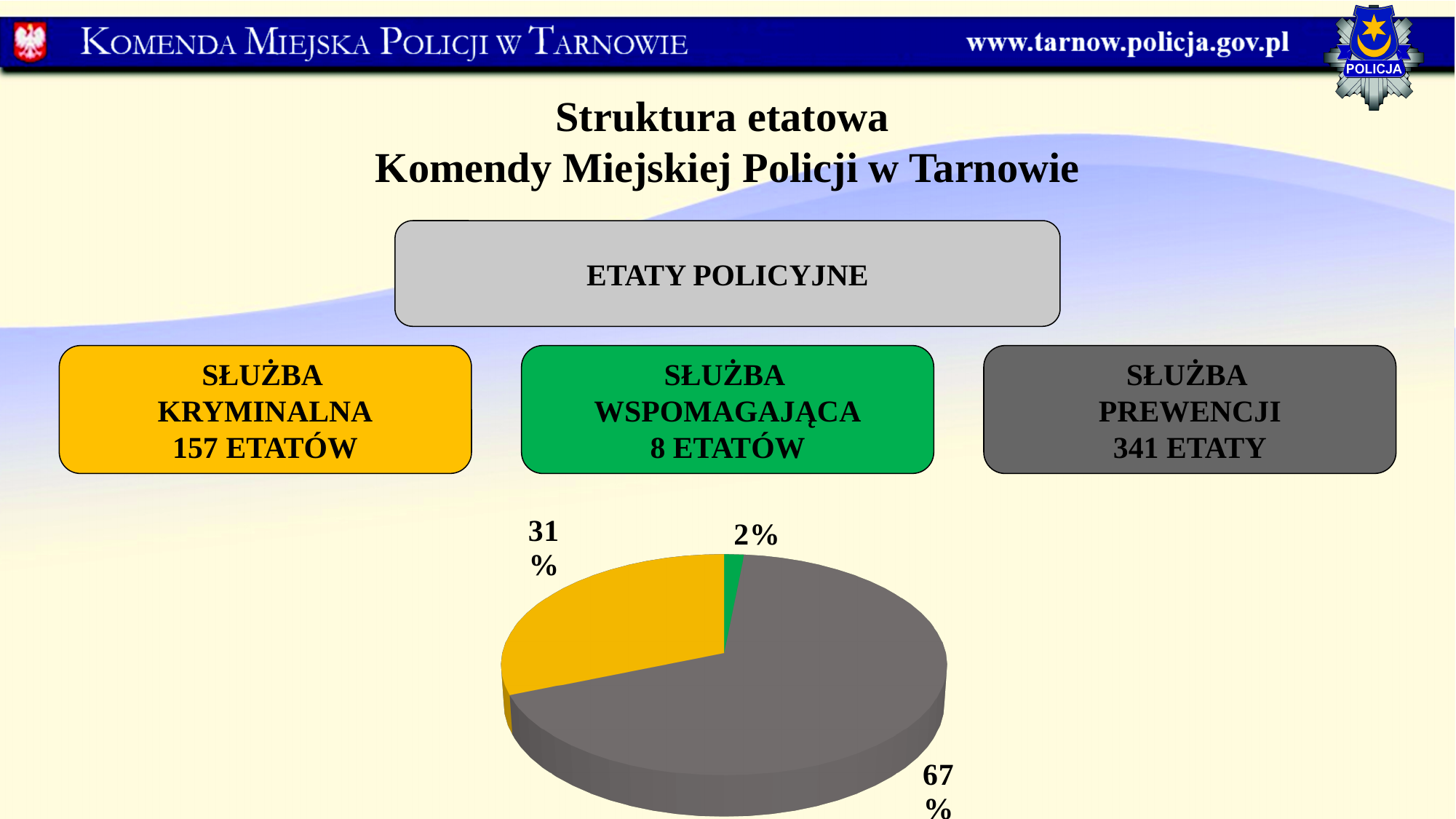
Which slice of the pie chart is the largest? the grey slice (67%) What percentage is shown for the green slice of the pie chart? 2% Which is larger in the pie chart, the yellow slice or the green slice? the yellow slice What percentage is shown for the grey slice of the pie chart? 67% Which service does the grey colour of the pie chart correspond to, according to the boxes above the chart? Służba Prewencji Is the share of the grey slice in the pie chart greater or less than 50%? greater Which slice of the pie chart is the smallest? the green slice (2%) What is the difference in percentage points between the grey slice and the yellow slice of the pie chart? 36 How many slices does the pie chart have? 3 What kind of chart is shown on the slide? pie chart How many etaty (posts) does the box for Służba Prewencji show? 341 etaty What percentage is shown for the yellow slice of the pie chart? 31%